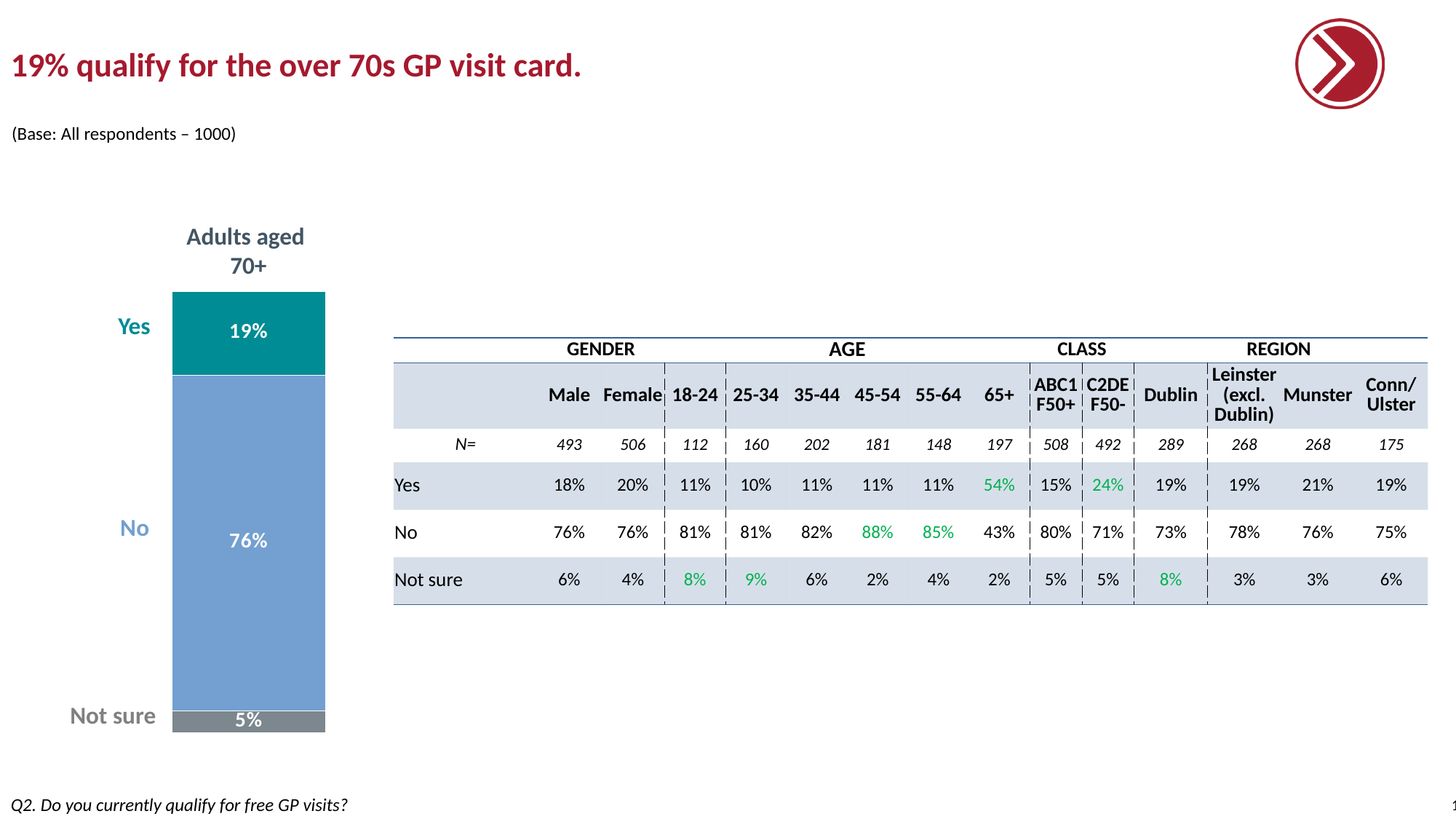
What value is shown for the "No" segment of the bar? 76% What is the difference between the "No" and "Yes" values in the bar? 57% Which segment of the stacked bar has the largest value? No What is the title above the stacked bar? Adults aged 70+ What percentage of the stacked bar is labelled "Yes"? 19% Which segment of the stacked bar has the smallest value? Not sure What kind of chart is shown on the slide? Stacked bar chart What is the total of the three segments in the stacked bar? 100% What value is shown for the "Not sure" segment of the bar? 5% What is the difference between the "Yes" and "Not sure" values in the bar? 14% Which is larger in the bar, the "Yes" value or the "Not sure" value? Yes How many segments make up the stacked bar? 3